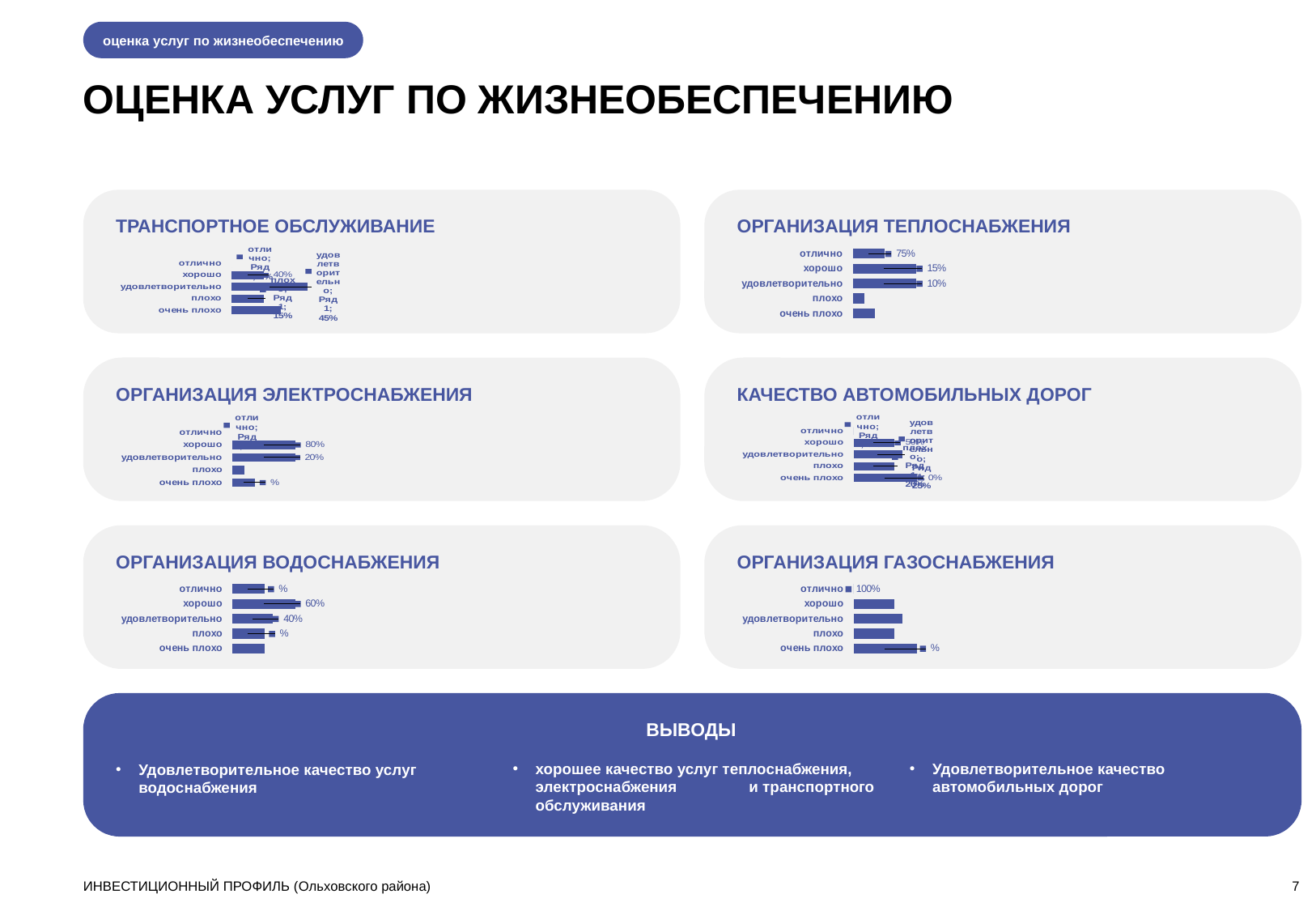
In the 'ОРГАНИЗАЦИЯ ЭЛЕКТРОСНАБЖЕНИЯ' chart, what value is labelled for 'хорошо'? 80% In the 'ОРГАНИЗАЦИЯ ВОДОСНАБЖЕНИЯ' chart, what value is labelled for 'хорошо'? 60% In the 'ОРГАНИЗАЦИЯ ВОДОСНАБЖЕНИЯ' chart, what value is labelled for 'удовлетворительно'? 40% In the 'ОРГАНИЗАЦИЯ ЭЛЕКТРОСНАБЖЕНИЯ' chart, what value is labelled for 'удовлетворительно'? 20% How many categories are listed on the vertical axis of the 'ОРГАНИЗАЦИЯ ВОДОСНАБЖЕНИЯ' chart? 5 In the 'ОРГАНИЗАЦИЯ ЭЛЕКТРОСНАБЖЕНИЯ' chart, which is larger, the value for 'хорошо' or for 'удовлетворительно'? хорошо In the 'ОРГАНИЗАЦИЯ ТЕПЛОСНАБЖЕНИЯ' chart, what is the difference between the labelled values for 'отлично' and 'хорошо'? 60% In the 'ОРГАНИЗАЦИЯ ТЕПЛОСНАБЖЕНИЯ' chart, what value is labelled for 'удовлетворительно'? 10% In the 'ОРГАНИЗАЦИЯ ТЕПЛОСНАБЖЕНИЯ' chart, what value is labelled for 'отлично'? 75% In the 'ОРГАНИЗАЦИЯ ГАЗОСНАБЖЕНИЯ' chart, what value is labelled for 'отлично'? 100% In the 'ОРГАНИЗАЦИЯ ТЕПЛОСНАБЖЕНИЯ' chart, what value is labelled for 'хорошо'? 15% What kind of chart is used in the 'ОРГАНИЗАЦИЯ ТЕПЛОСНАБЖЕНИЯ' panel? bar chart